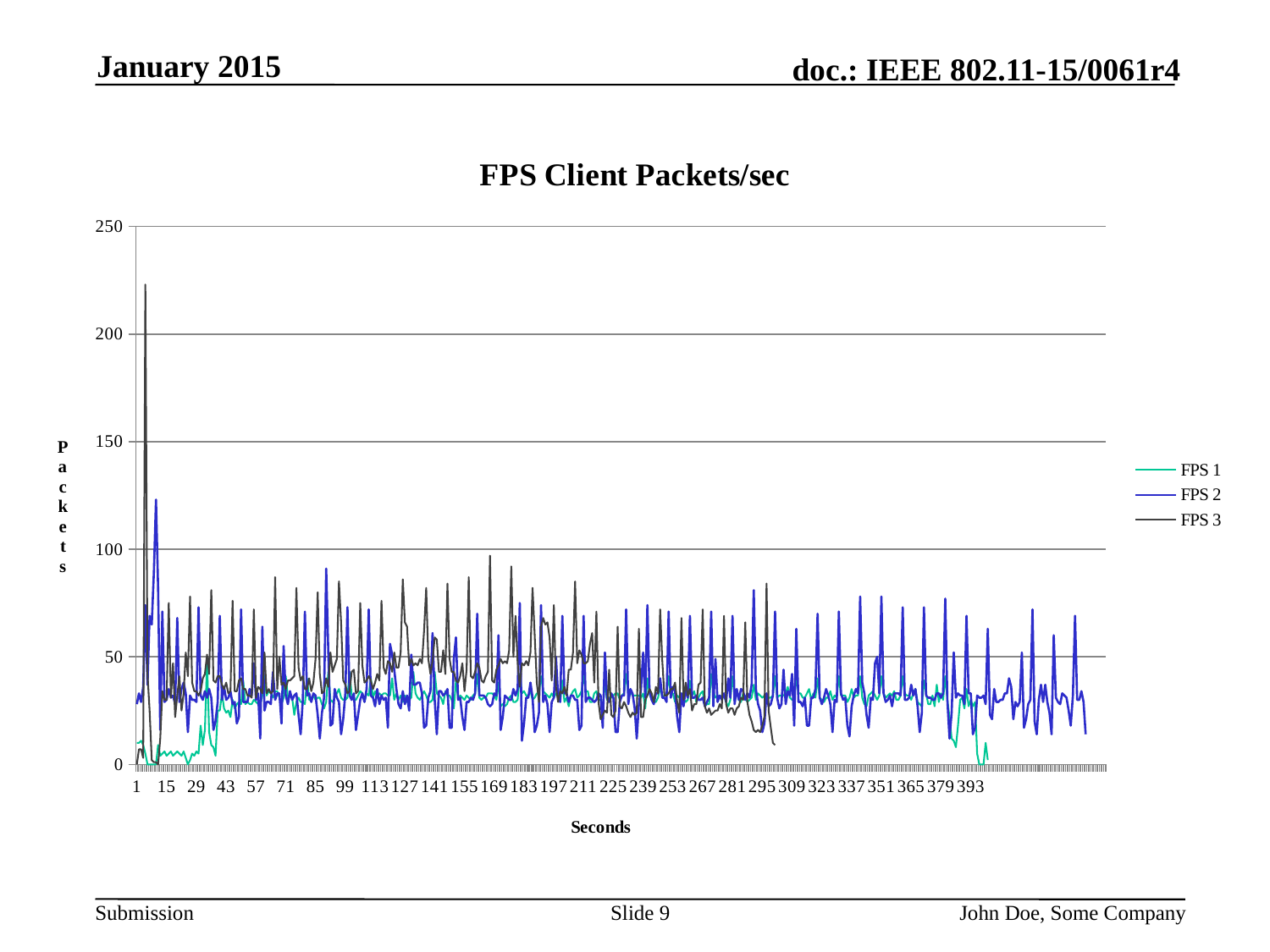
Is the highest peak of FPS 2 greater or less than 150? less Is the highest peak of FPS 1 greater or less than 100? less Is the highest peak of FPS 2 greater or less than 100? greater What is the label of the x axis? Seconds What is the title of the chart? FPS Client Packets/sec Which series has the lower values near the start of the x axis (around second 1 to 29), FPS 1 or FPS 2? FPS 1 How many series does the legend list? 3 What is the highest value shown on the y axis? 250 Which series reaches the highest peak value on the chart? FPS 3 What kind of chart is shown on the slide? line chart